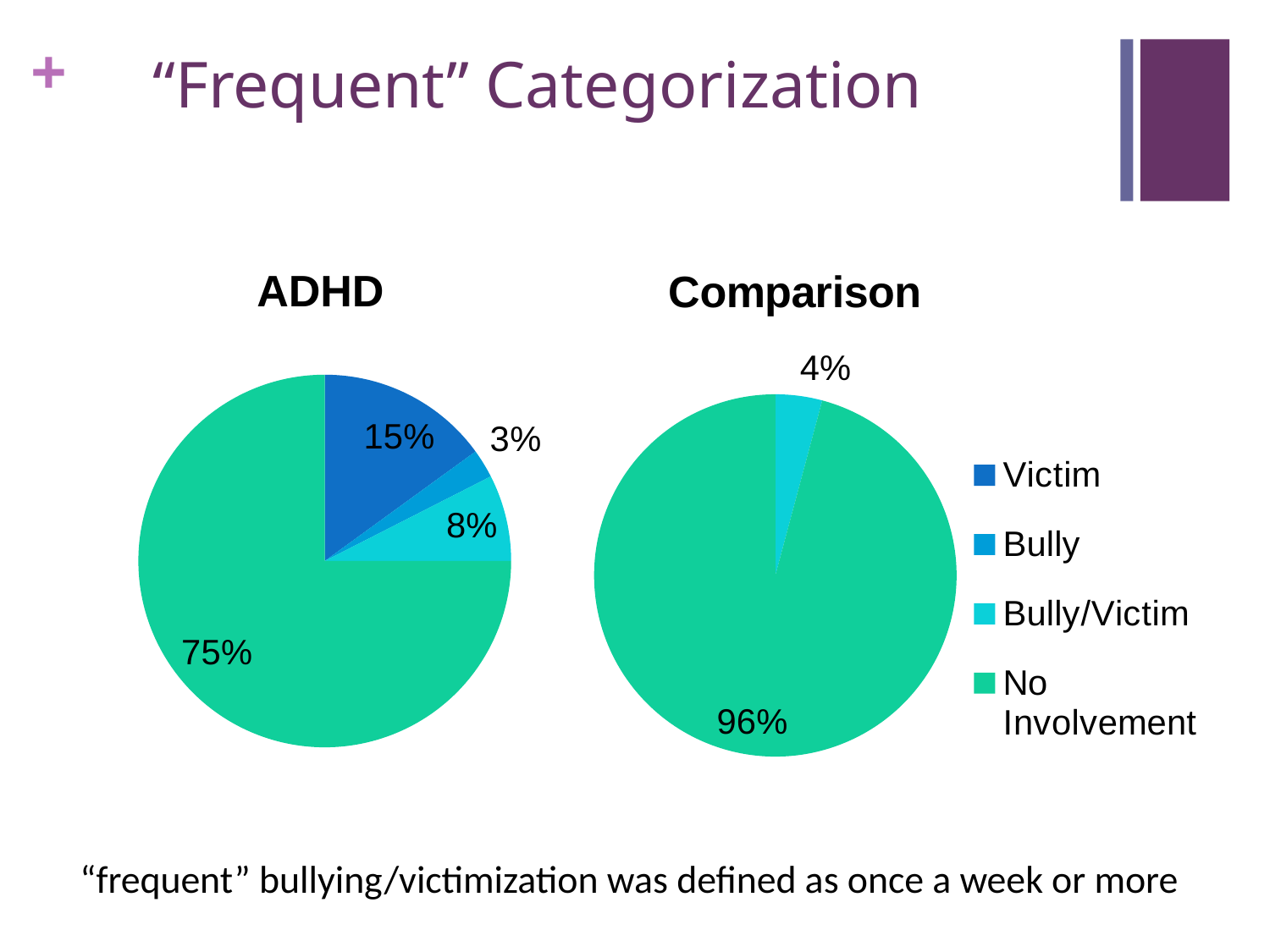
In the ADHD pie chart, what percentage is labelled for the No Involvement slice? 75% How many entries does the legend list? 4 In the ADHD pie chart, which is larger, the Victim share or the Bully/Victim share? Victim What type of chart is used for the ADHD and Comparison groups? Pie chart What is the difference between the No Involvement share in the Comparison pie chart and the No Involvement share in the ADHD pie chart? 21% In the Comparison pie chart, what percentage is labelled for the Bully/Victim slice? 4% In the ADHD pie chart, which category has the largest share? No Involvement In the Comparison pie chart, what percentage is labelled for the No Involvement slice? 96% In the ADHD pie chart, what percentage is labelled for the Bully/Victim slice? 8% In the ADHD pie chart, what percentage is labelled for the Victim slice? 15% In the ADHD pie chart, which category has the smallest share? Bully In the ADHD pie chart, what percentage is labelled for the Bully slice? 3%